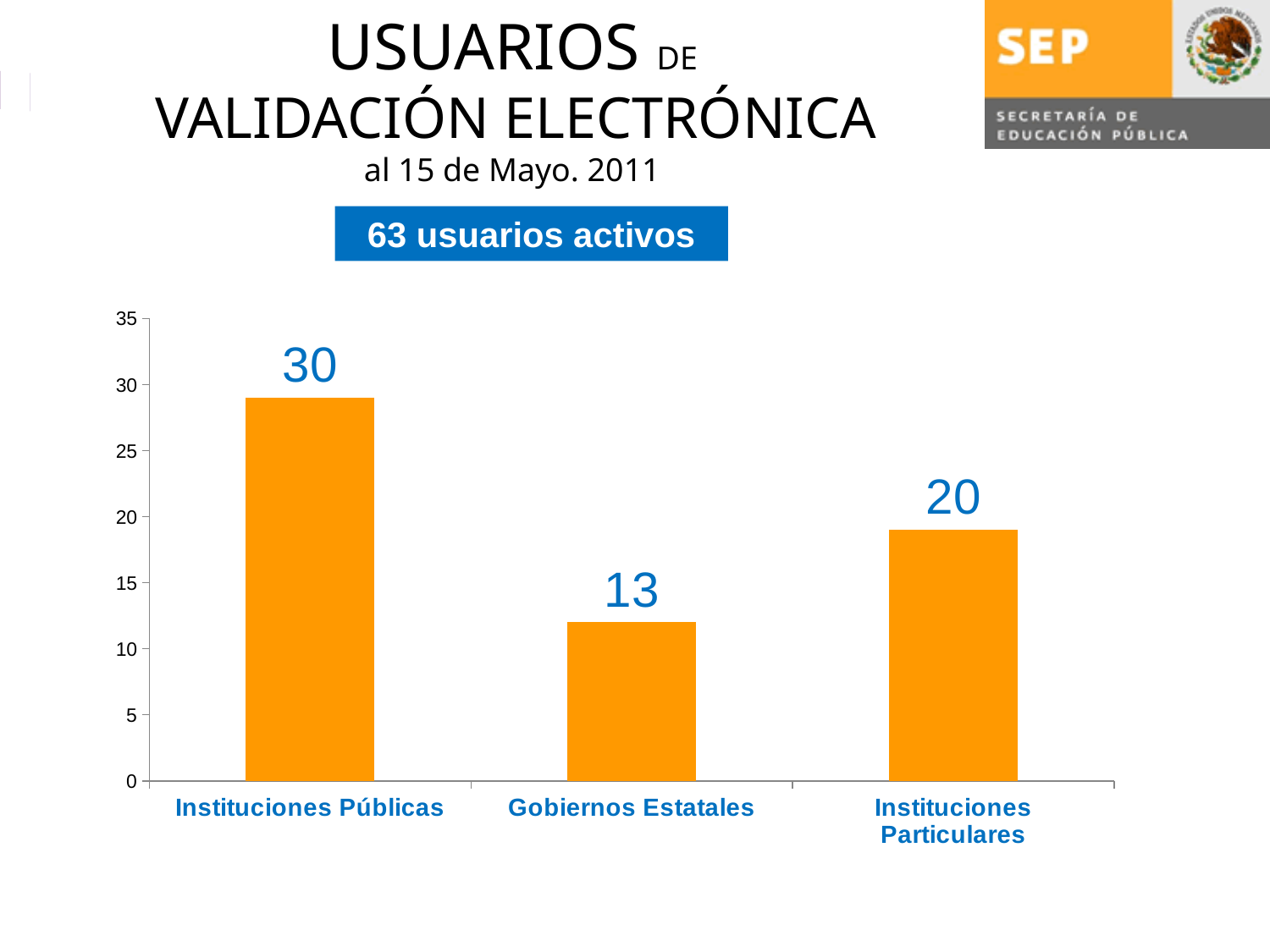
Which category has the highest value? Instituciones Públicas What is the value for Instituciones Particulares? 20 What is the total of the three values shown in the chart? 63 What is the difference between the values for Instituciones Particulares and Gobiernos Estatales? 7 What is the difference between the values for Instituciones Públicas and Gobiernos Estatales? 17 Which category has the lowest value? Gobiernos Estatales How many categories are shown on the x axis? 3 What is the value for Gobiernos Estatales? 13 Is the value for Instituciones Públicas greater or less than 25? greater What kind of chart is shown on the slide? bar chart Which is larger, the value for Instituciones Particulares or the value for Gobiernos Estatales? Instituciones Particulares What is the value for Instituciones Públicas? 30